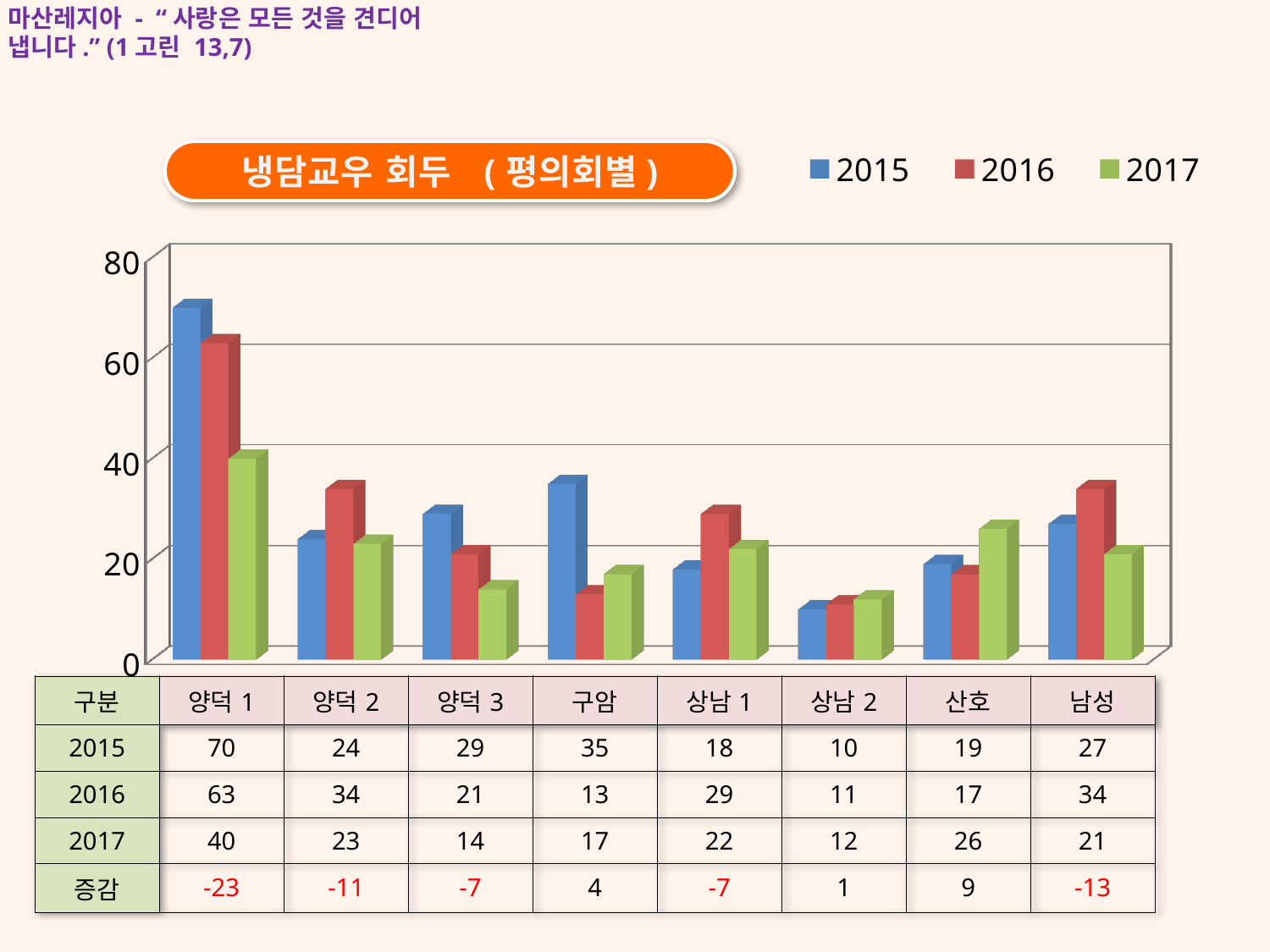
What is the 2015 value for 양덕 1? 70 Which category has the highest 2015 value? 양덕 1 What is the 2017 value for 산호? 26 What is the 증감 value shown for 산호 in the table? 9 What is the difference between the 2015 and 2017 values for 양덕 1? 30 What is the 2016 value for 구암? 13 How many categories are shown on the x axis? 8 Which category has the lowest 2016 value? 상남 2 Is the 2015 value for 구암 greater or less than 20? greater How many series does the legend list? 3 Which is larger for 남성: the 2016 value or the 2017 value? 2016 What kind of chart is shown? bar chart